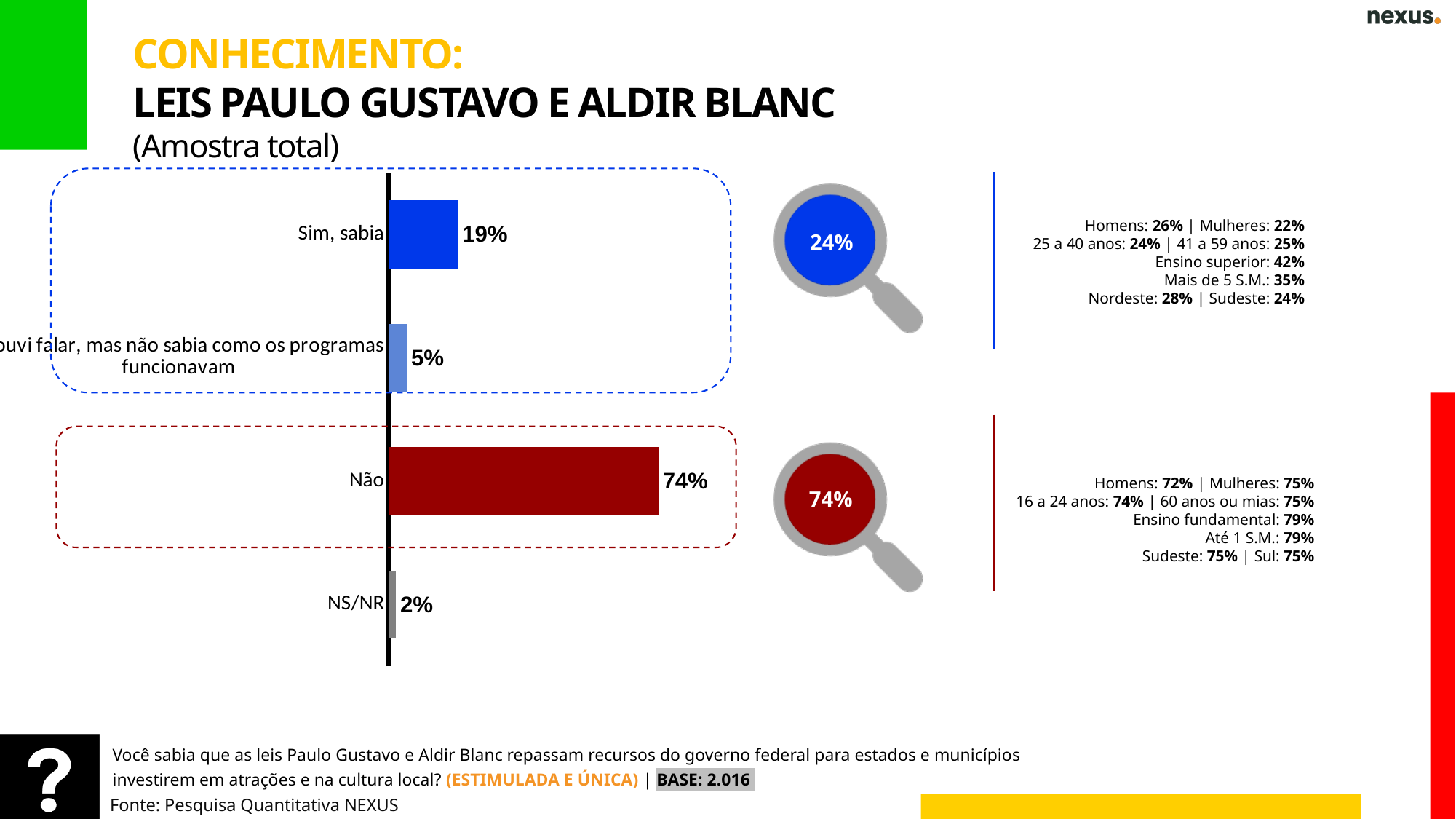
Which is larger, the value for "Sim, sabia" or the value for "NS/NR"? Sim, sabia What percentage is shown for the second bar, "ouvi falar, mas não sabia como os programas funcionavam"? 5% Which category has the lowest value in the bar chart? NS/NR What kind of chart is shown on the slide? Bar chart What percentage is shown for "Sim, sabia"? 19% How many categories are plotted in the bar chart? 4 Which category has the highest value in the bar chart? Não What percentage is shown for "Não"? 74% What percentage is shown for "NS/NR"? 2% What colour is the bar for "Não"? Dark red What is the combined value of "Sim, sabia" and the "ouvi falar" bar, as shown in the blue magnifying-glass circle? 24% What is the difference between the values for "Não" and "Sim, sabia"? 55%